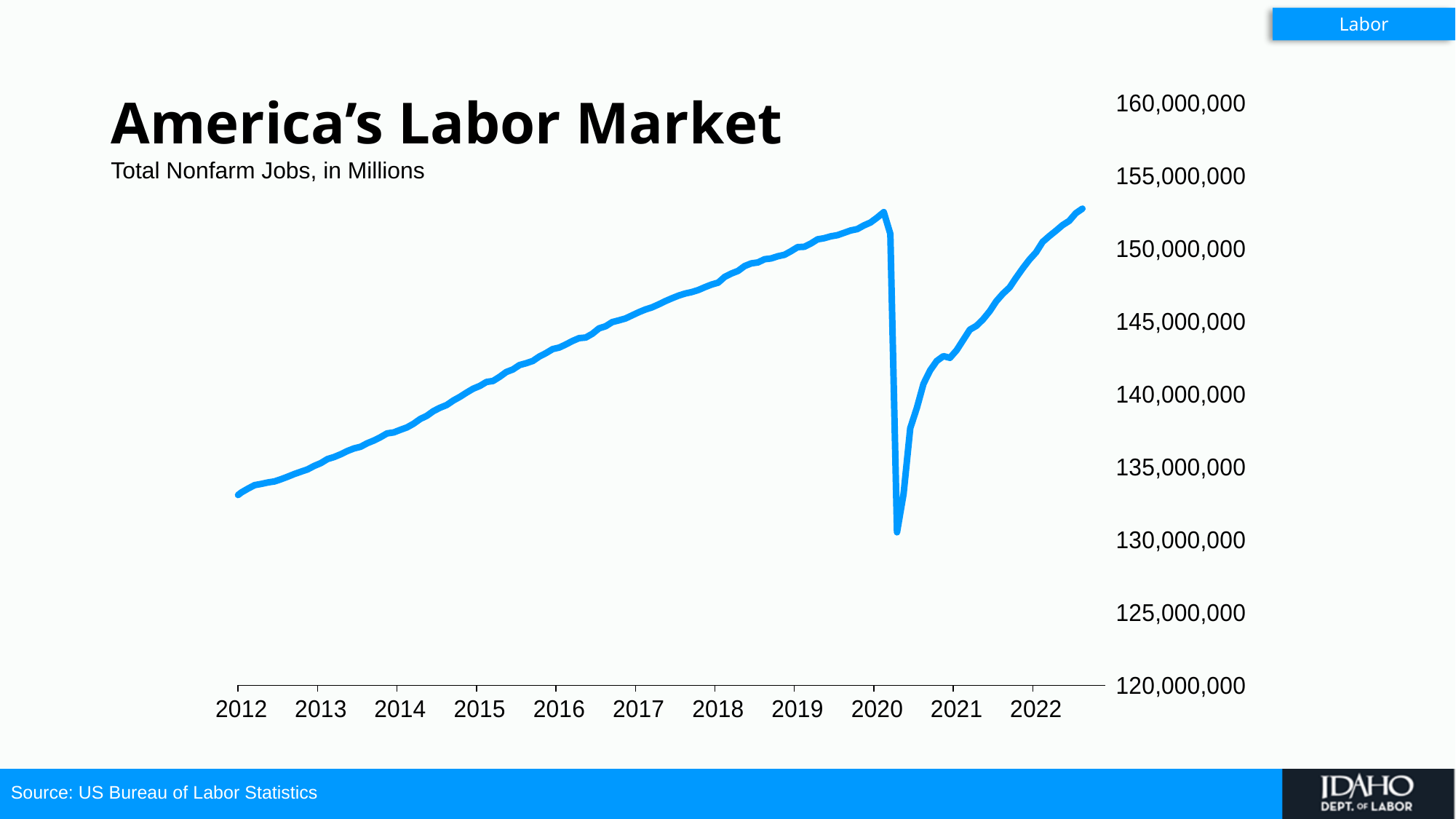
What kind of chart is shown on the slide? line chart Is the value at the end of the line in 2022 greater or less than 150,000,000? greater What does the subtitle say the chart measures? Total Nonfarm Jobs, in Millions Is the value at the start of 2016 greater or less than 140,000,000? greater Is the value at the start of 2012 greater or less than 135,000,000? less In which year does the line reach its highest point? 2022 What is the title of the chart on the slide? America's Labor Market In which year does the line reach its lowest point? 2020 How many years are labeled on the x axis? 11 Between 2012 and the start of 2020, do the values rise or fall? rise